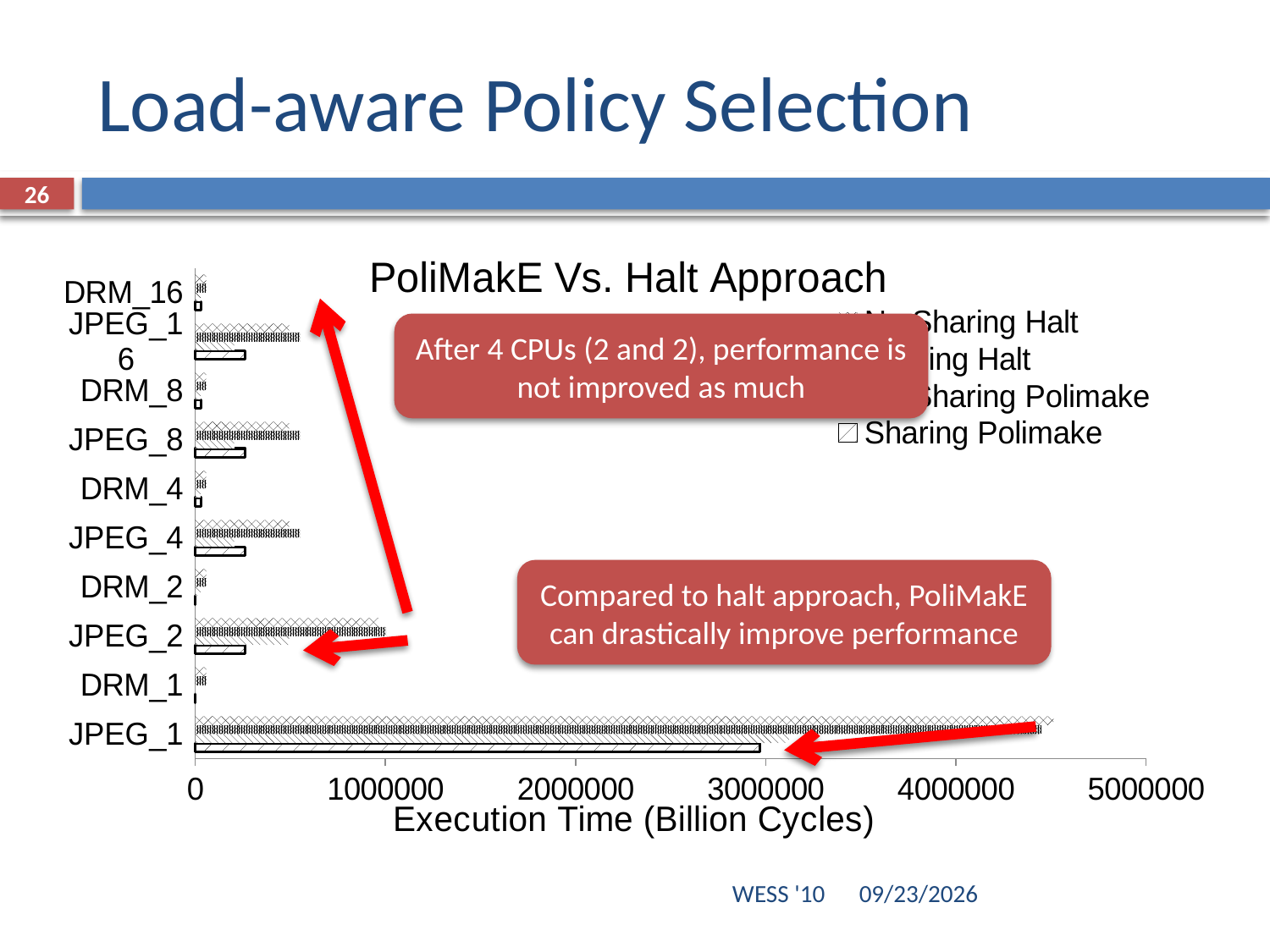
What type of chart is shown on the slide? bar chart How many categories are shown on the y axis of the chart? 10 Which category has longer bars, JPEG_2 or DRM_2? JPEG_2 What is the title of the chart? PoliMakE Vs. Halt Approach Is the longest bar for JPEG_4 greater or less than 1000000? less What is the label of the x axis of the chart? Execution Time (Billion Cycles) Which category has longer bars, JPEG_1 or JPEG_2? JPEG_1 Is the longest bar for JPEG_1 greater or less than 4000000? greater How many series does the chart's legend list? 4 What is the highest value shown on the x axis of the chart? 5000000 Is the longest bar for JPEG_8 greater or less than 1000000? less Which category has the longest bar in the chart? JPEG_1